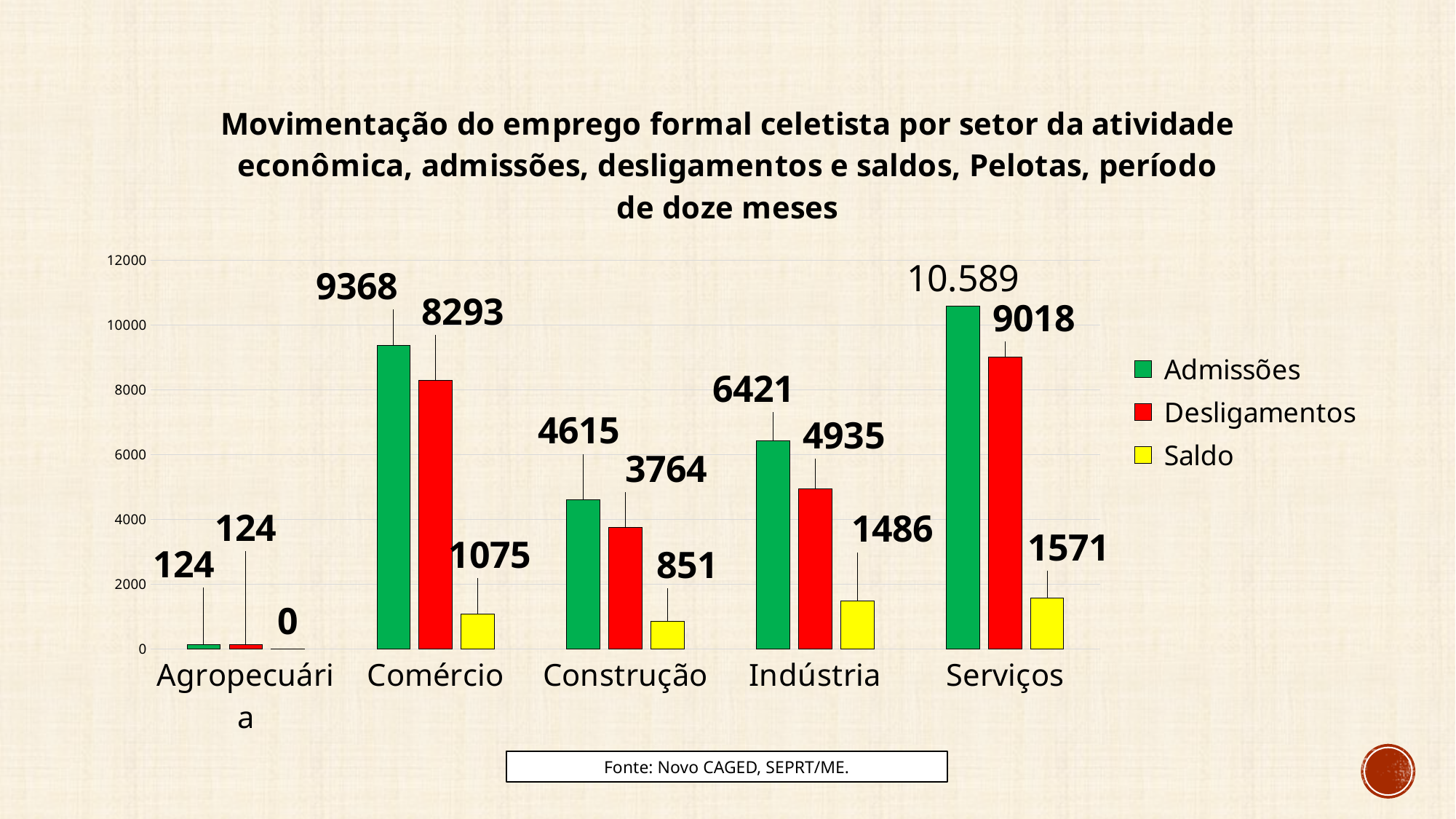
What is the value of Admissões for Serviços? 10.589 How many sectors are shown on the x axis? 5 How many series does the legend list? 3 What kind of chart is shown on the slide? Bar chart What is the value of Desligamentos for Indústria? 4935 What is the value of Admissões for Comércio? 9368 Which sector has the highest value of Admissões? Serviços Which is larger for Indústria: Admissões or Desligamentos? Admissões Which sector has the lowest value of Saldo? Agropecuária What is the difference between Admissões and Desligamentos for Construção? 851 What colour represents the Saldo series in the chart? Yellow What is the value of Saldo for Serviços? 1571